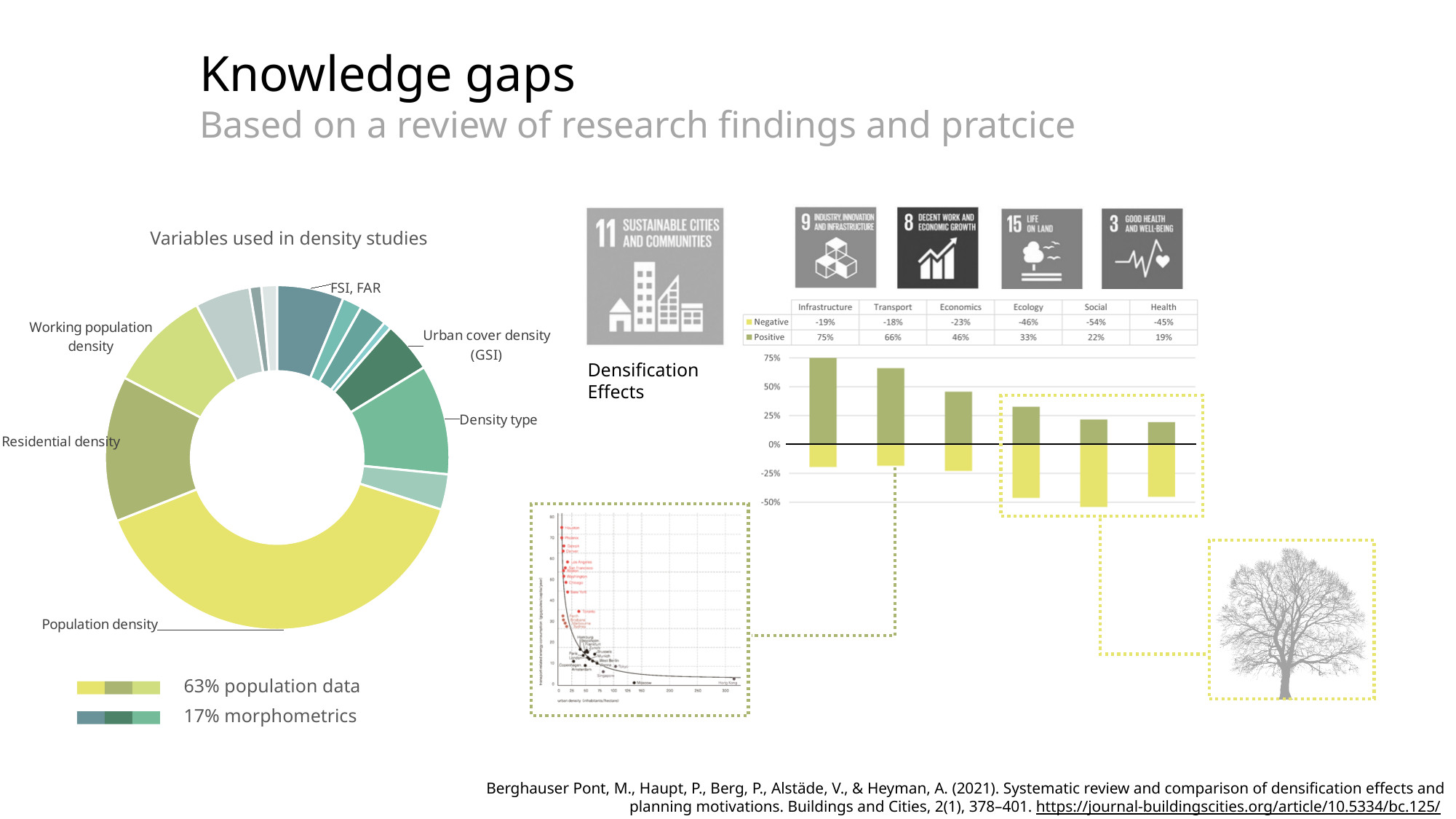
In the Densification Effects chart, which has the larger Positive value, Economics or Ecology? Economics In the Densification Effects chart, which category has the highest Positive value? Infrastructure In the Densification Effects chart, what is the Positive value for Infrastructure? 75% What kind of chart is the Densification Effects chart? Bar chart How many categories are shown in the Densification Effects chart? 6 In the Densification Effects chart, do the Positive values rise or fall from Infrastructure to Health? Fall In the Densification Effects chart, what is the difference between the Positive values for Infrastructure and Transport? 9% In the Densification Effects chart, which category has the lowest Positive value? Health In the 'Variables used in density studies' chart, which variable has the largest slice? Population density In the Densification Effects chart, what is the Negative value for Social? -54% In the Densification Effects chart, what is the Negative value for Ecology? -46% How many series does the Densification Effects chart's table list? 2